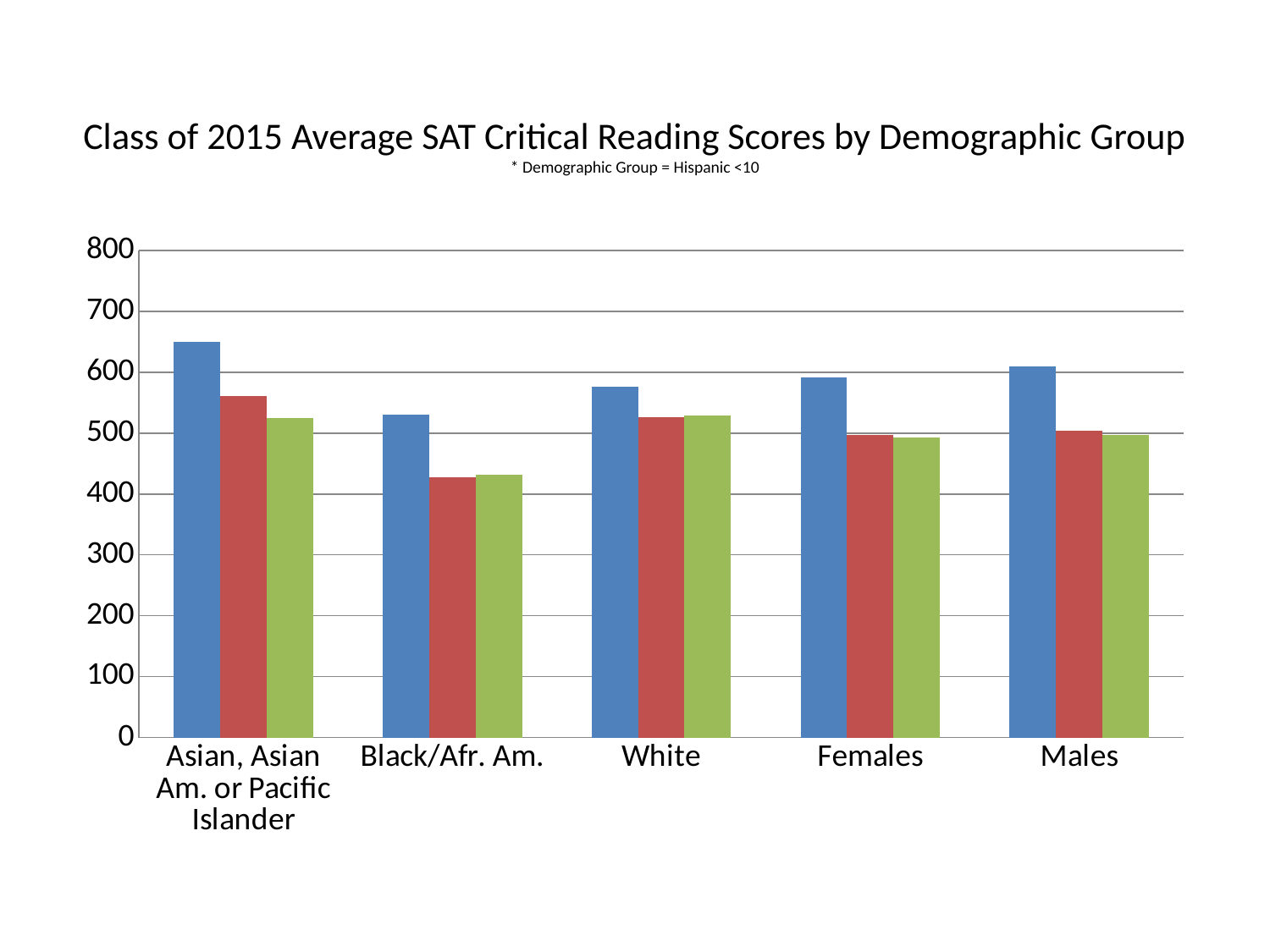
Which is taller, the blue bar for Asian, Asian Am. or Pacific Islander or the blue bar for White? Asian, Asian Am. or Pacific Islander Which category has the tallest blue bar? Asian, Asian Am. or Pacific Islander Is the blue bar for Asian, Asian Am. or Pacific Islander greater or less than 600? greater How many bars are plotted for each demographic group category? 3 What does the note under the chart title say? * Demographic Group = Hispanic <10 Which category has the shortest blue bar? Black/Afr. Am. What is the title of the chart? Class of 2015 Average SAT Critical Reading Scores by Demographic Group Which category has the shortest red bar? Black/Afr. Am. How many demographic group categories are shown on the x axis? 5 Is the red bar for Black/Afr. Am. greater or less than 500? less Is the green bar for White greater or less than 500? greater What kind of chart is shown on the slide? bar chart